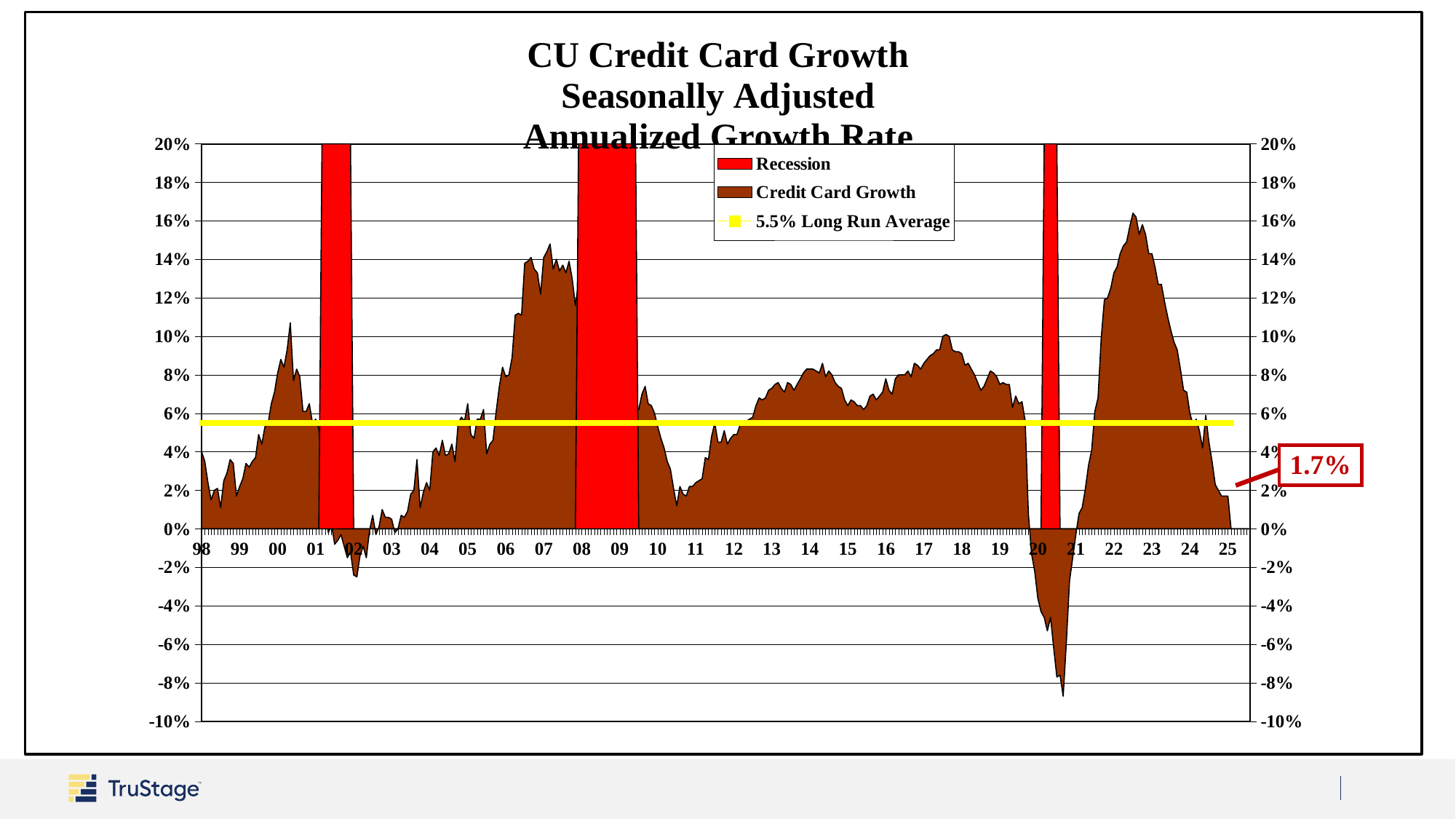
Do credit card growth values rise or fall from 2023 to 2025? fall How many recession periods are shaded on the chart? 3 Which is higher: the peak credit card growth in 2000 or the peak in 2007? 2007 What colour are the recession bars on the chart? Red What is the most recent credit card growth value called out on the chart? 1.7% What kind of chart is shown on the slide? Area chart Is the peak credit card growth value in 2022 greater or less than 14%? greater How many entries does the legend list? 3 Is the lowest credit card growth value in 2002 greater or less than 0%? less Is the peak credit card growth value in 2017 greater or less than 8%? greater What is the long run average growth rate shown by the yellow line? 5.5%